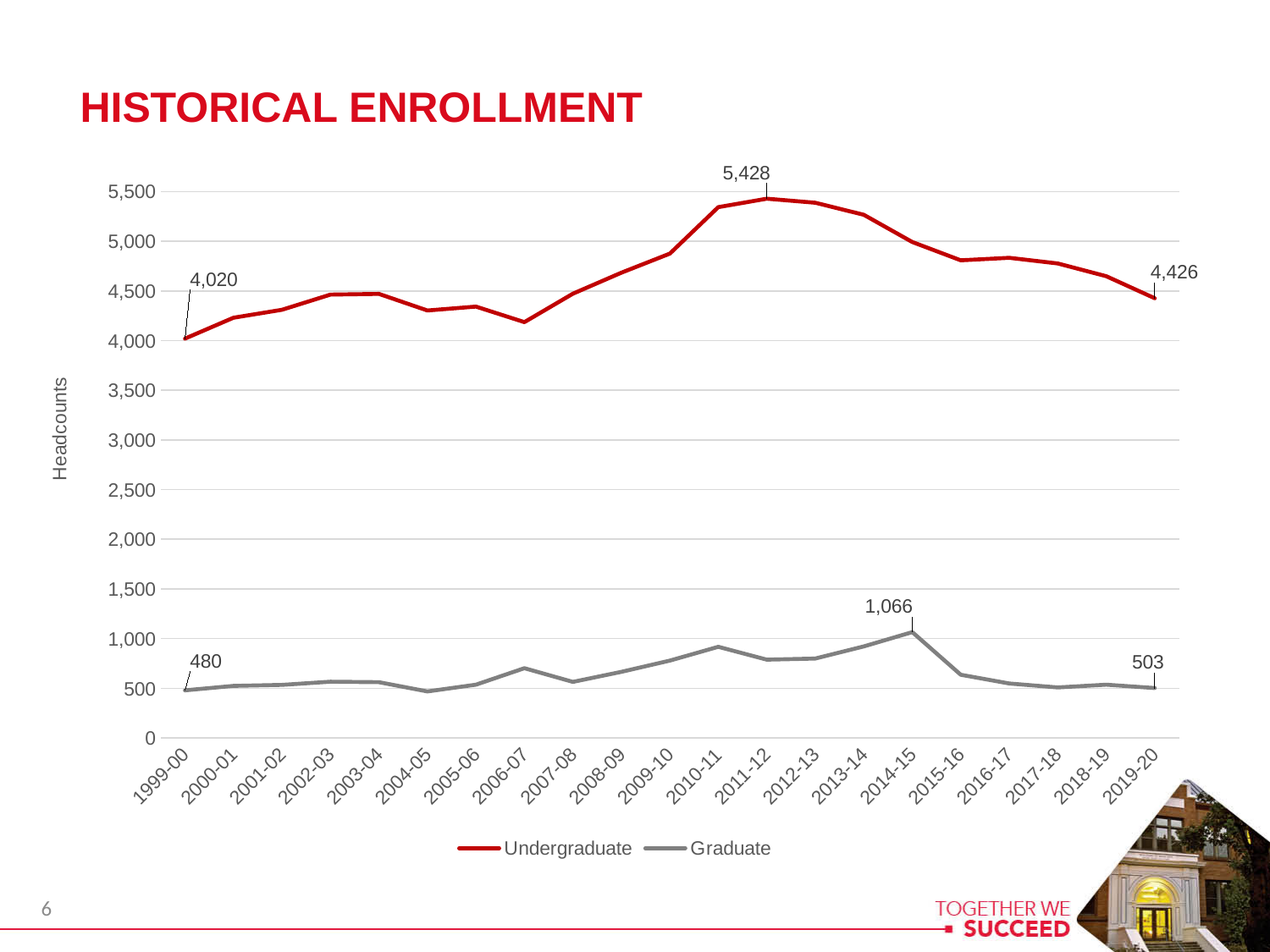
In which academic year does the Undergraduate series reach its highest value? 2011-12 In which academic year does the Graduate series reach its highest value? 2014-15 Is the Undergraduate headcount for 2015-16 greater or less than 5,000? less What is the Undergraduate headcount for 2019-20? 4,426 What is the Undergraduate headcount for 1999-00? 4,020 What is the Graduate headcount for 2019-20? 503 How many academic years are plotted along the x axis? 21 How many series does the legend list? 2 What kind of chart is shown on the slide? Line chart What is the Graduate headcount for 2014-15? 1,066 Which is larger, the Graduate headcount in 1999-00 or in 2019-20? 2019-20 What is the difference between the Undergraduate peak of 5,428 and the 2019-20 Undergraduate value of 4,426? 1,002